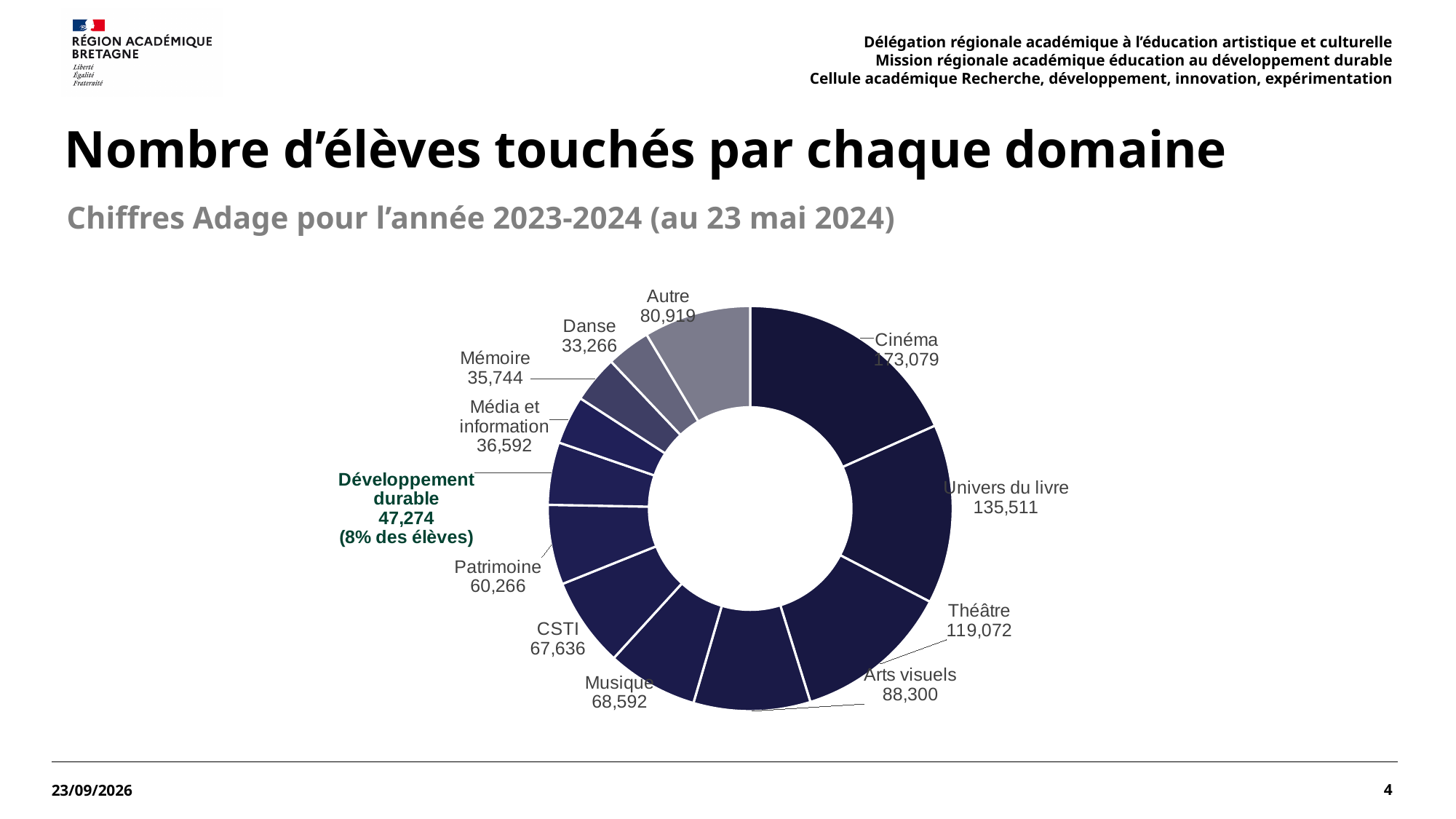
What type of chart is shown on the slide? Pie chart (donut) What is the value for Danse? 33,266 How many students were reached by Cinéma? 173,079 Which is larger, Musique or CSTI? Musique Which labelled domain has the lowest value? Danse What percentage of students is indicated for Développement durable? 8% Which domain label is shown in green on the chart? Développement durable Which domain reached the most students? Cinéma What is the value for Développement durable? 47,274 What is the difference between Cinéma and Univers du livre? 37,568 What is the title of the slide? Nombre d’élèves touchés par chaque domaine What is the value for Univers du livre? 135,511